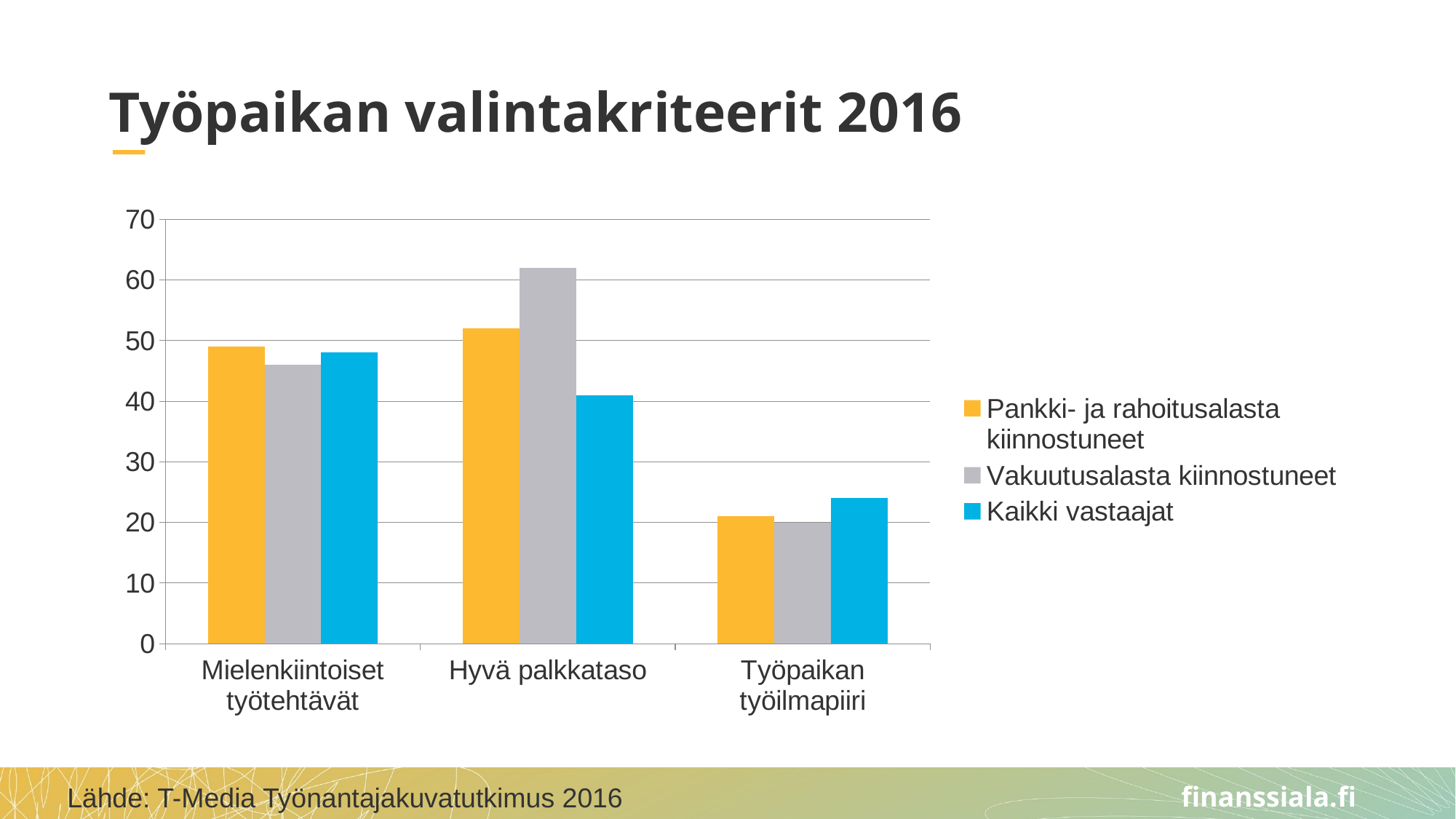
What is the title of the chart slide? Työpaikan valintakriteerit 2016 Is the value for Kaikki vastaajat in Hyvä palkkataso greater or less than 50? less What kind of chart is shown on the slide? bar chart In Työpaikan työilmapiiri, which is larger: Kaikki vastaajat or Vakuutusalasta kiinnostuneet? Kaikki vastaajat Which series is shown in blue in the legend? Kaikki vastaajat Is the value for Pankki- ja rahoitusalasta kiinnostuneet in Työpaikan työilmapiiri greater or less than 30? less Which category has the lowest bar for Kaikki vastaajat? Työpaikan työilmapiiri How many series does the legend list? 3 Which category has the highest bar for Vakuutusalasta kiinnostuneet? Hyvä palkkataso How many categories are shown on the x axis of the chart? 3 Is the value for Vakuutusalasta kiinnostuneet in Hyvä palkkataso greater or less than 60? greater In Hyvä palkkataso, which is larger: Vakuutusalasta kiinnostuneet or Kaikki vastaajat? Vakuutusalasta kiinnostuneet